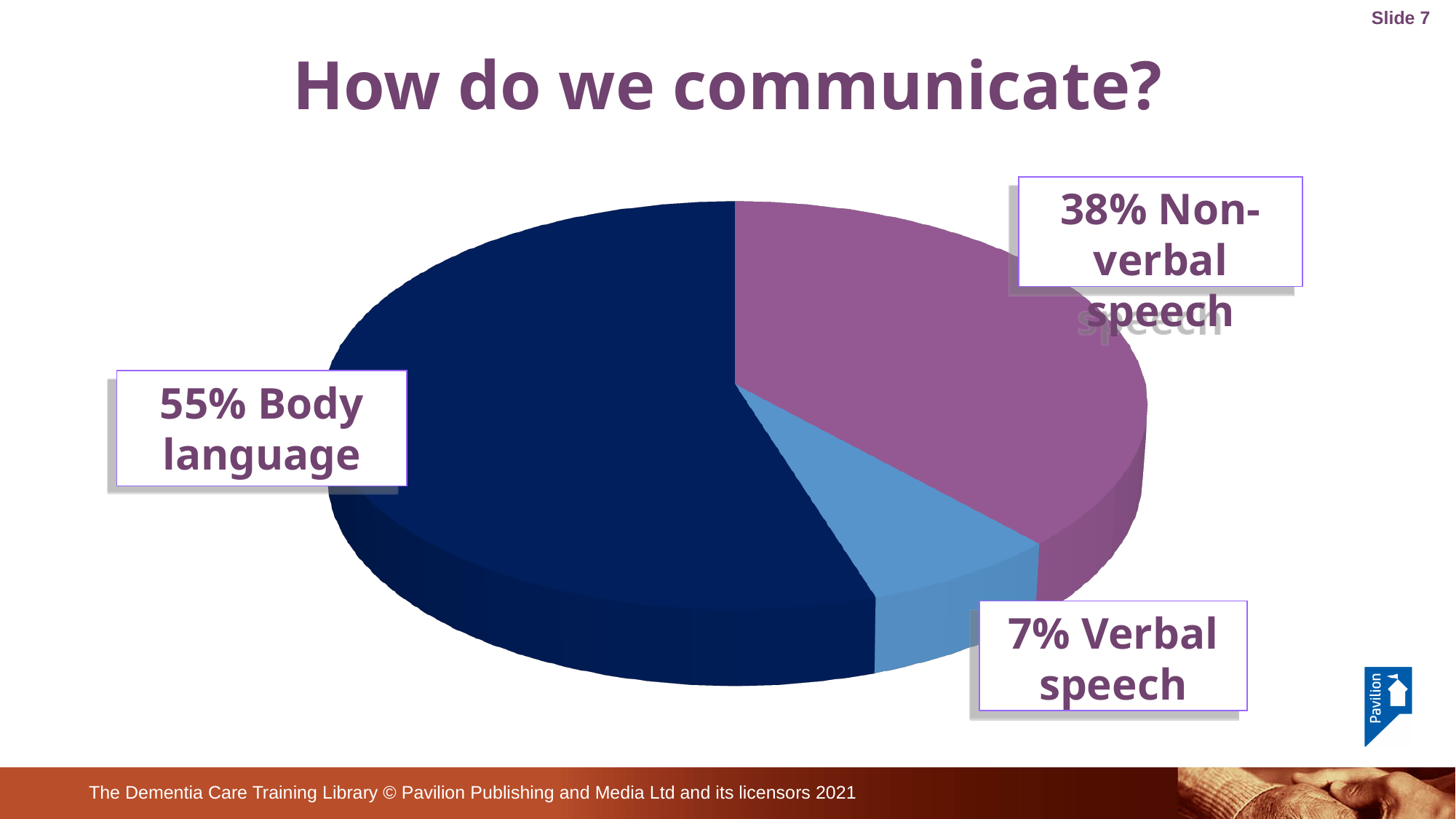
What is the difference between the Non-verbal speech share and the Verbal speech share? 31% How many slices does the pie chart have? 3 What share of the pie is Non-verbal speech? 38% Which category has the largest slice of the pie? Body language What colour is the Body language slice? dark navy blue What kind of chart is shown on the slide? pie chart What is the title of the chart on the slide? How do we communicate? Which is larger, the share for Non-verbal speech or the share for Verbal speech? Non-verbal speech What share of the pie is Body language? 55% What is the difference between the Body language share and the Non-verbal speech share? 17% What share of the pie is Verbal speech? 7% Which category has the smallest slice of the pie? Verbal speech